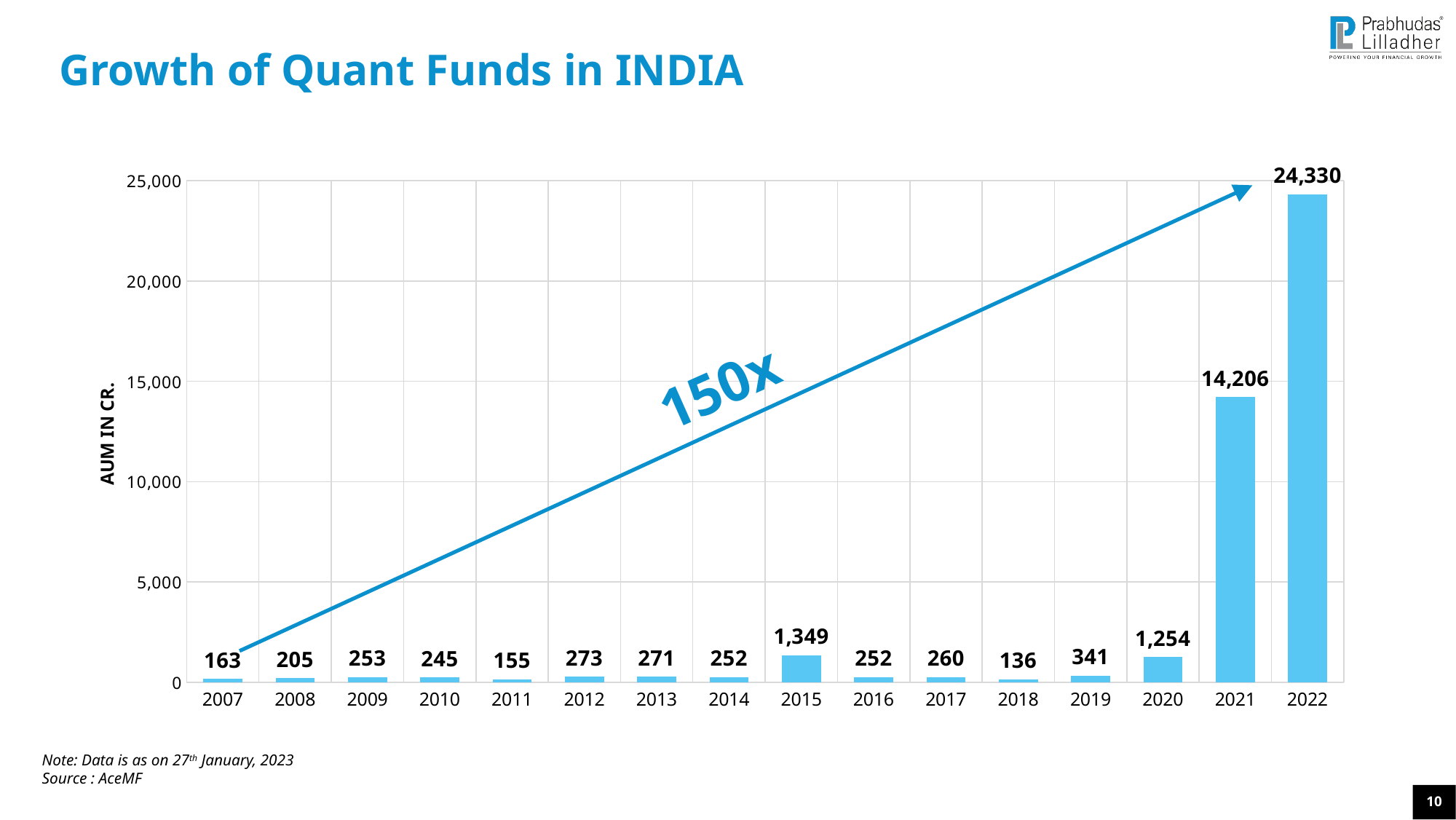
What is the difference in AUM between 2022 and 2021? 10,124 What is the AUM in Cr. for 2007? 163 What growth multiple is written along the arrow on the chart? 150x What is the AUM in Cr. for 2022? 24,330 How many years are shown on the x axis? 16 Which year has the highest AUM? 2022 What kind of chart is shown on the slide? Bar chart Which year has the lowest AUM? 2018 Which year has a larger AUM, 2020 or 2019? 2020 Is the value for 2021 greater or less than 10,000? greater What is the AUM in Cr. for 2015? 1,349 What is the label of the y axis? AUM IN CR.